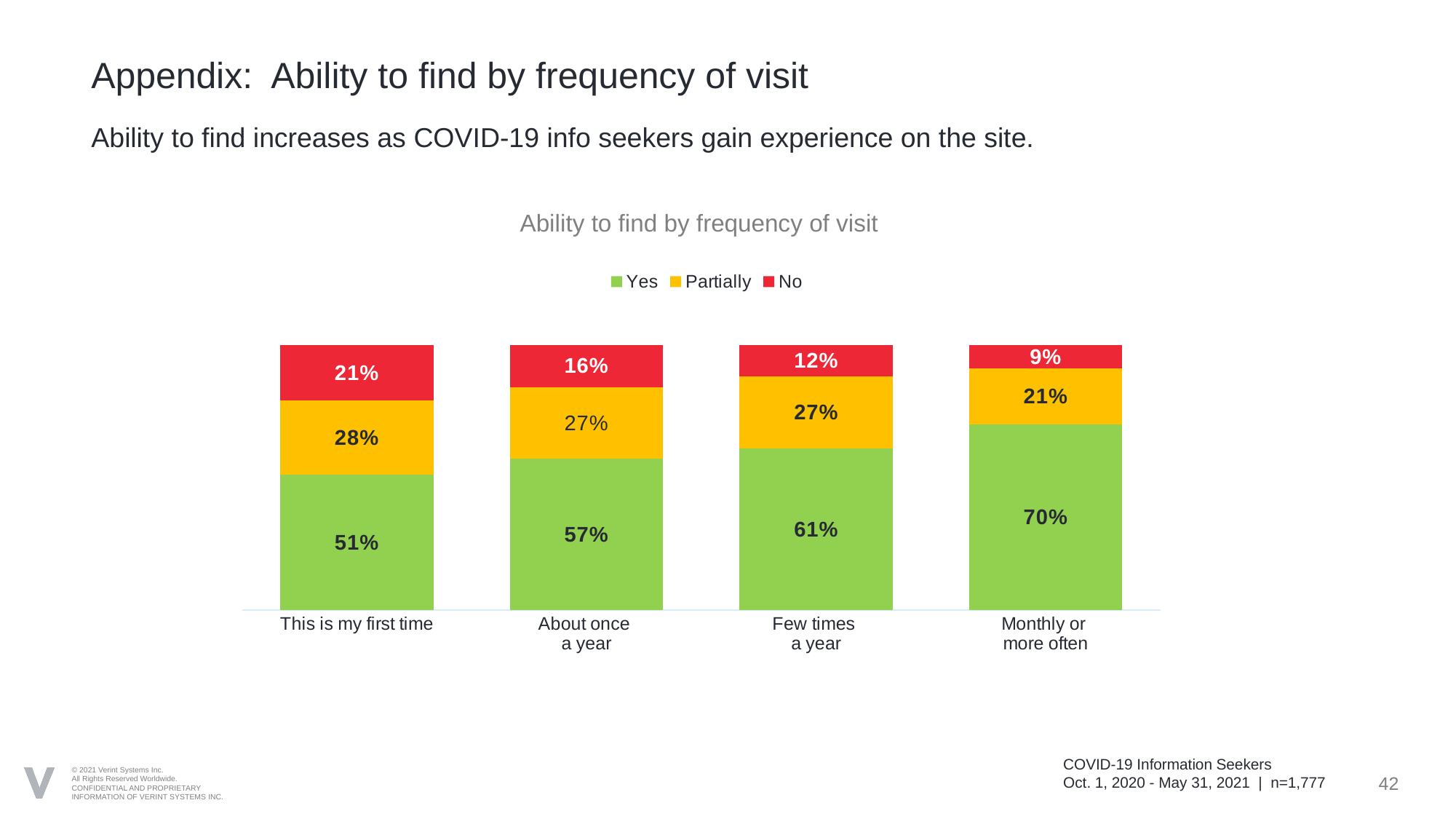
How many series does the legend list? 3 What percentage of 'This is my first time' visitors answered Yes? 51% Do the 'Yes' values rise or fall from left to right across the categories? Rise What is the difference between the 'Yes' values for 'Monthly or more often' and 'This is my first time'? 19% What is the 'No' value for the 'Monthly or more often' category? 9% How many categories are shown on the x axis? 4 What is the 'Partially' value for 'About once a year'? 27% Which category has the highest 'Yes' value? Monthly or more often Which is larger: the 'No' value for 'This is my first time' or for 'Few times a year'? This is my first time What kind of chart is shown on the slide? Stacked bar chart What is the title of the chart? Ability to find by frequency of visit Which category has the lowest 'No' value? Monthly or more often